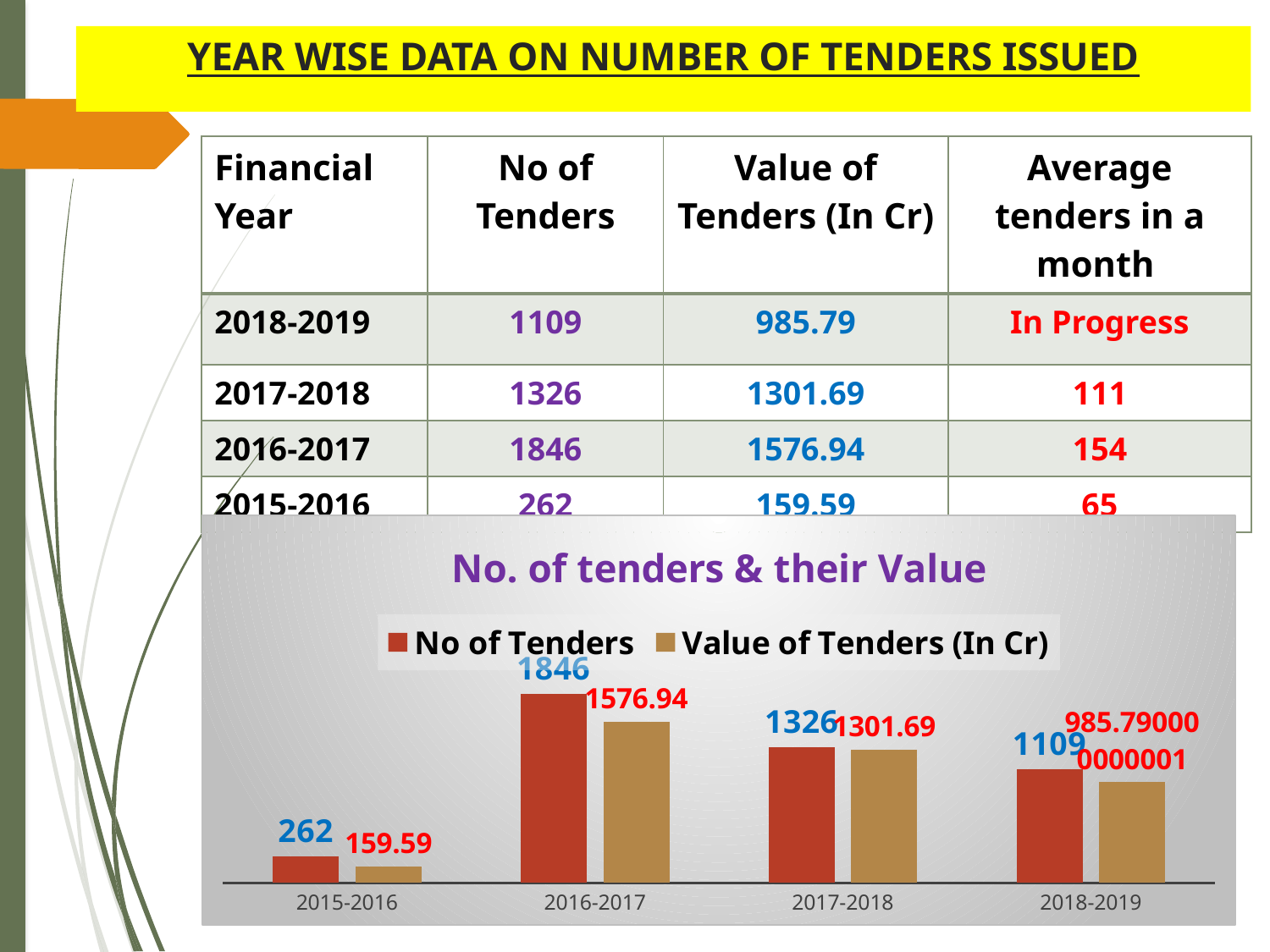
What is the Value of Tenders (In Cr) for 2015-2016 in the chart? 159.59 In the chart, which is larger for 2018-2019: No of Tenders or Value of Tenders (In Cr)? No of Tenders What is the title of the chart on the slide? No. of tenders & their Value Which financial year has the highest No of Tenders in the chart? 2016-2017 What is the No of Tenders value for 2017-2018 in the chart? 1326 What is the No of Tenders value for 2016-2017 in the chart? 1846 What type of chart is shown on the slide? bar chart What is the difference between the No of Tenders for 2016-2017 and 2017-2018 in the chart? 520 How many series does the chart legend list? 2 What is the Value of Tenders (In Cr) for 2017-2018 in the chart? 1301.69 How many financial years are shown on the x axis of the chart? 4 Which financial year has the lowest Value of Tenders (In Cr) in the chart? 2015-2016